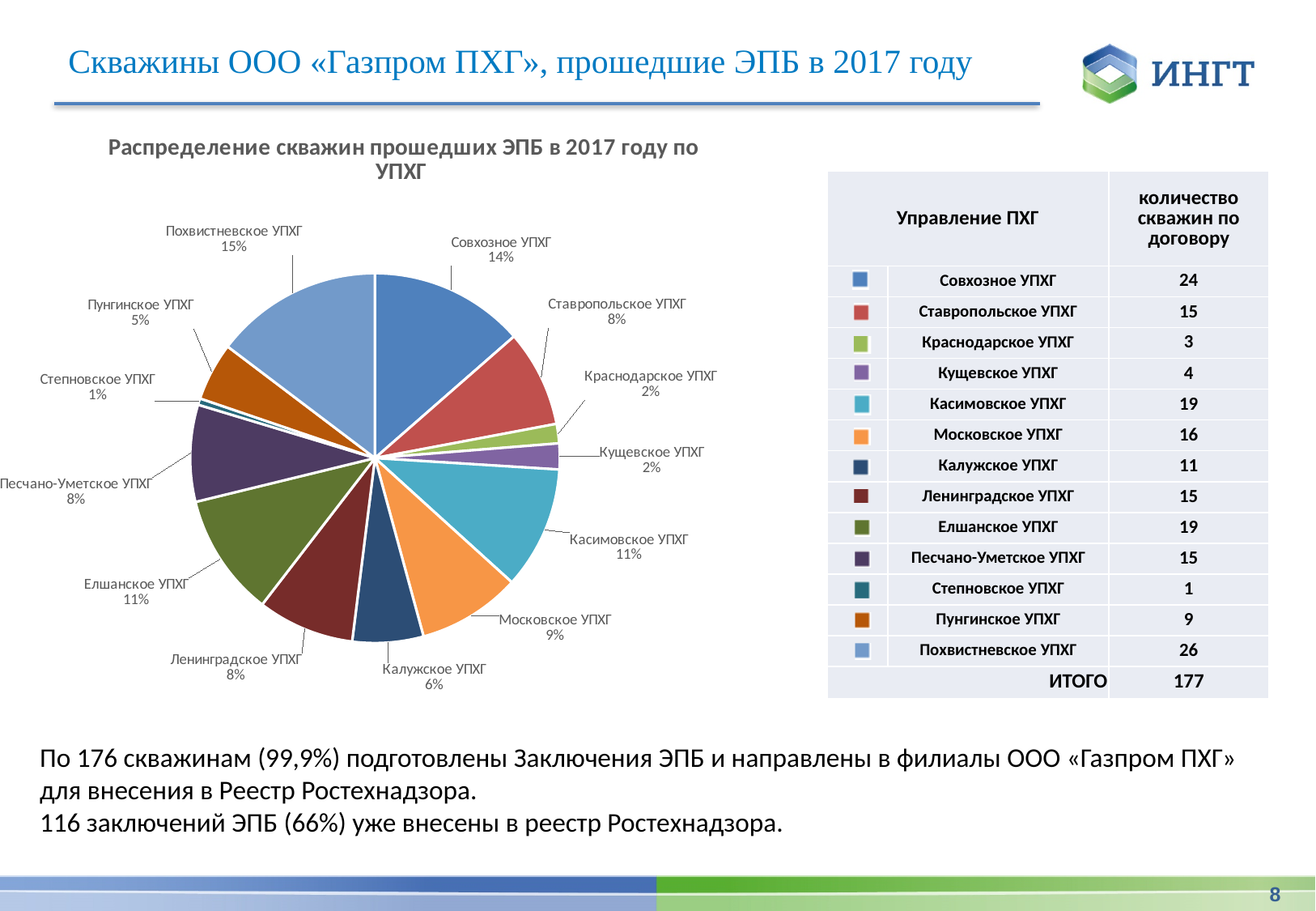
What type of chart is used on the slide? Pie chart What percentage is shown for Касимовское УПХГ in the pie chart? 11% What share of the pie chart does Похвистневское УПХГ account for? 15% By how many percentage points does the share of Похвистневское УПХГ exceed that of Совхозное УПХГ? 1 Which УПХГ has the largest slice in the pie chart? Похвистневское УПХГ Which УПХГ has the smallest slice in the pie chart? Степновское УПХГ What percentage is shown for Калужское УПХГ in the pie chart? 6% What percentage is shown for Московское УПХГ in the pie chart? 9% What is the title of the chart on the slide? Распределение скважин прошедших ЭПБ в 2017 году по УПХГ Which has the larger share in the pie chart, Касимовское УПХГ or Московское УПХГ? Касимовское УПХГ How many УПХГ categories are shown in the pie chart? 13 What percentage is shown for Совхозное УПХГ in the pie chart? 14%